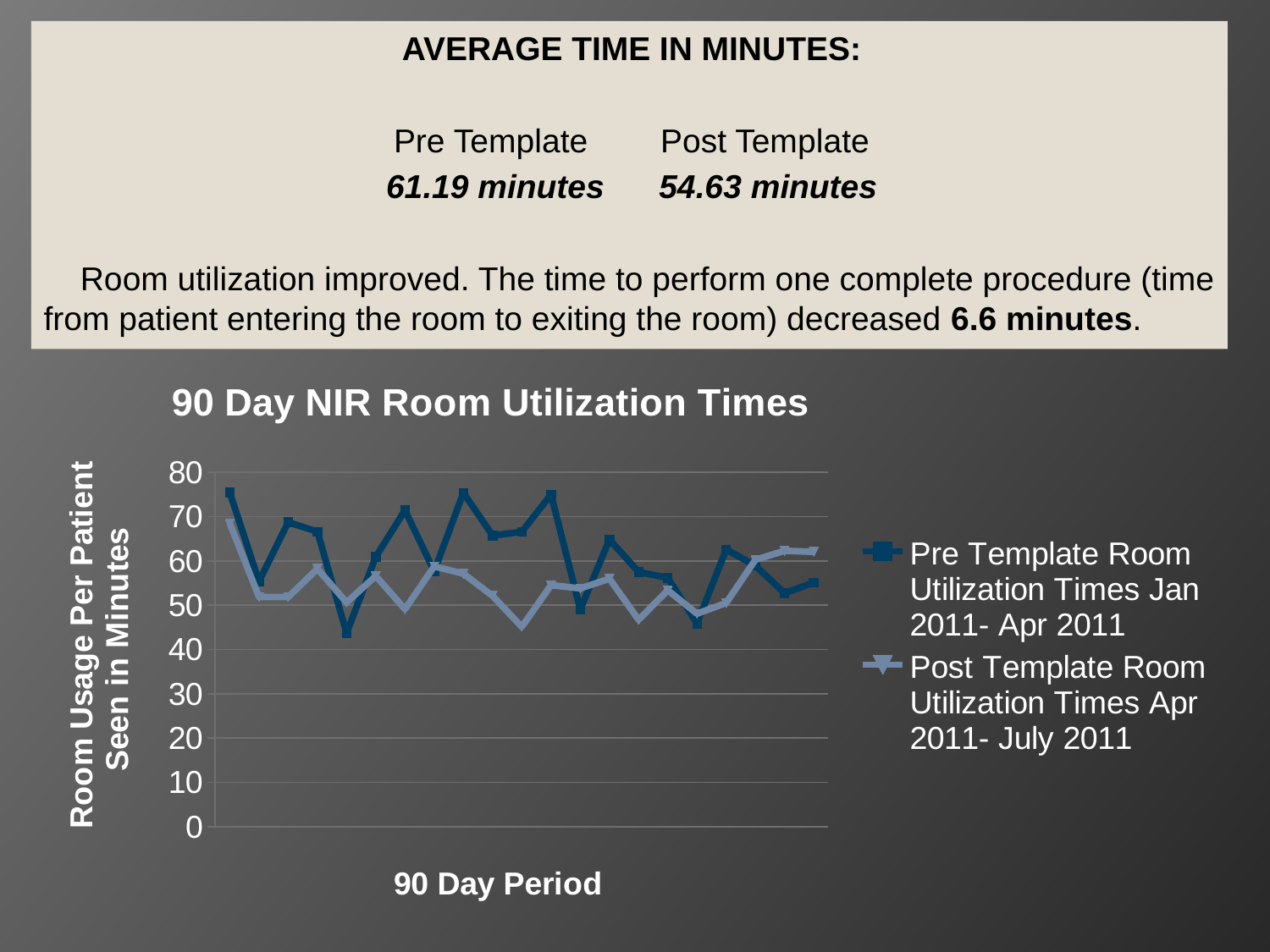
What is the title of the chart? 90 Day NIR Room Utilization Times Is the lowest point of the Pre Template Room Utilization Times series greater or less than 50? less What is the highest value shown on the y axis of the chart? 80 Does the Pre Template Room Utilization Times series end higher or lower than it starts? lower What kind of chart is shown on the slide? line chart How many series does the legend of the chart list? 2 Which series has the higher first point, Pre Template or Post Template Room Utilization Times? Pre Template Room Utilization Times What is the label on the x axis of the chart? 90 Day Period Is the first point of the Pre Template Room Utilization Times series greater or less than 70? greater Is the first point of the Post Template Room Utilization Times series greater or less than 60? greater